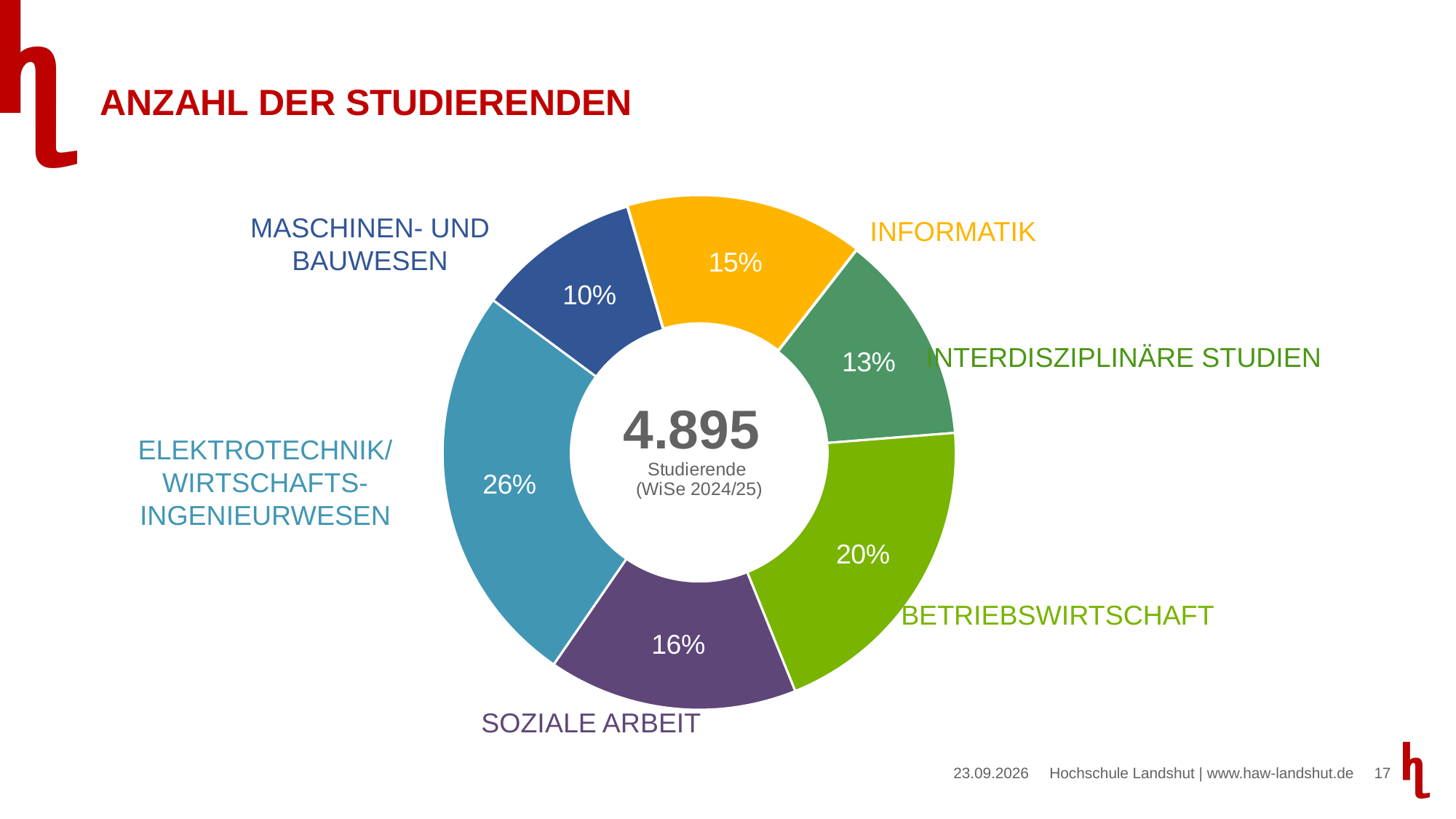
What share of students does Elektrotechnik/Wirtschaftsingenieurwesen account for? 26% What total number of students is shown in the centre of the chart? 4.895 Which has a larger share, Informatik or Interdisziplinäre Studien? Informatik Which faculty has the largest share of students? Elektrotechnik/Wirtschaftsingenieurwesen Which faculty has the smallest share of students? Maschinen- und Bauwesen How many faculties (segments) are shown in the chart? 6 What is the title of the slide? ANZAHL DER STUDIERENDEN What kind of chart is shown on the slide? Pie chart (donut) How many percentage points larger is the Betriebswirtschaft share than the Maschinen- und Bauwesen share? 10 What percentage is shown for Interdisziplinäre Studien? 13% What percentage is shown for Soziale Arbeit? 16% What percentage is shown for Informatik? 15%